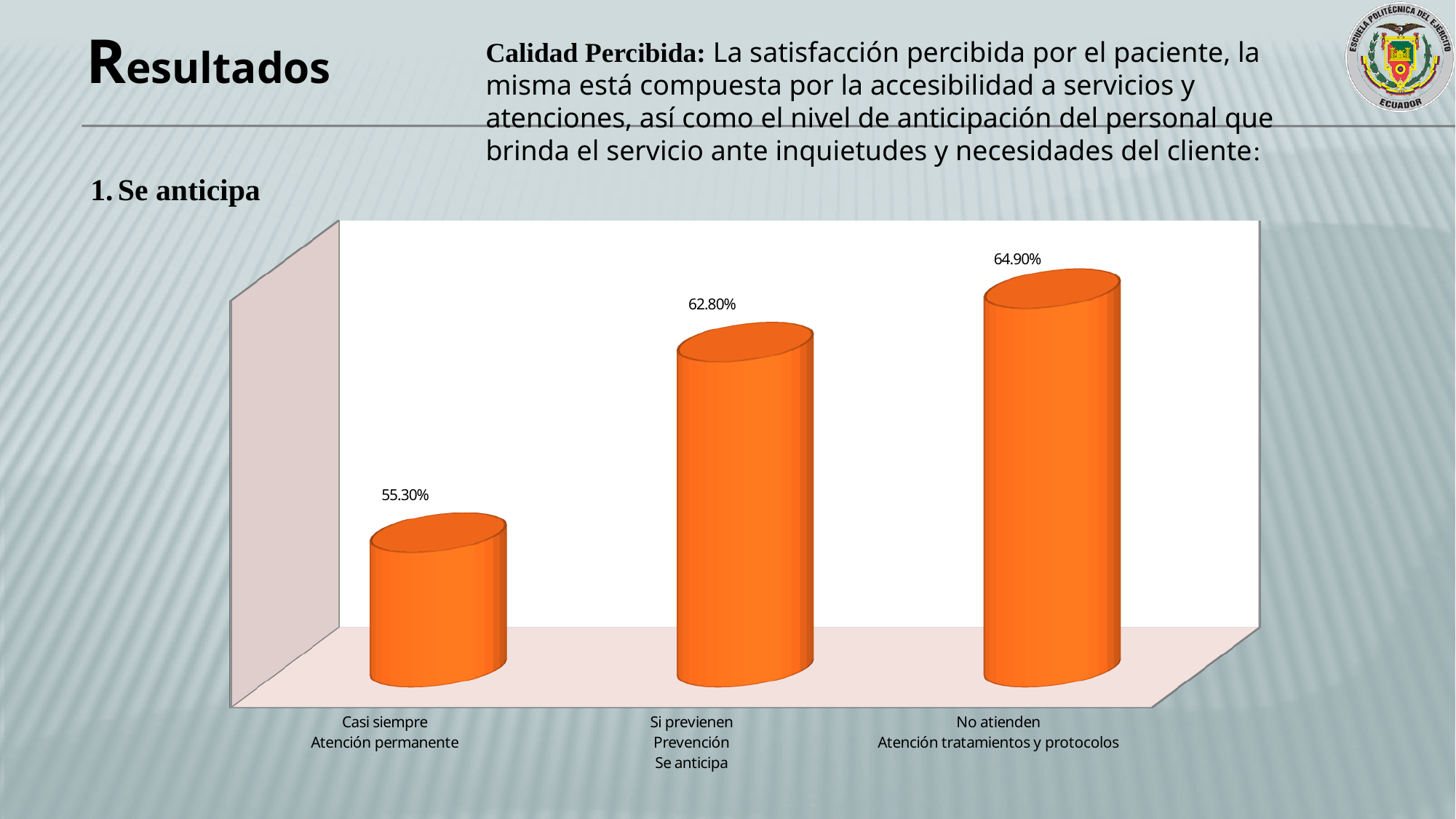
Which is larger, the value for "Si previenen" or the value for "Casi siempre"? Si previenen What is the value for "Si previenen / Prevención"? 62.80% Which category has the highest value? No atienden / Atención tratamientos y protocolos What is the value for "Casi siempre / Atención permanente"? 55.30% Do the values rise or fall from left to right across the categories? Rise How many categories are shown in the chart? 3 What is the difference between the values for "No atienden" and "Casi siempre"? 9.60% What colour are the bars in the chart? Orange Which category has the lowest value? Casi siempre / Atención permanente What is the value for "No atienden / Atención tratamientos y protocolos"? 64.90% What kind of chart is shown on the slide? Bar chart What is the difference between the values for "Si previenen" and "Casi siempre"? 7.50%